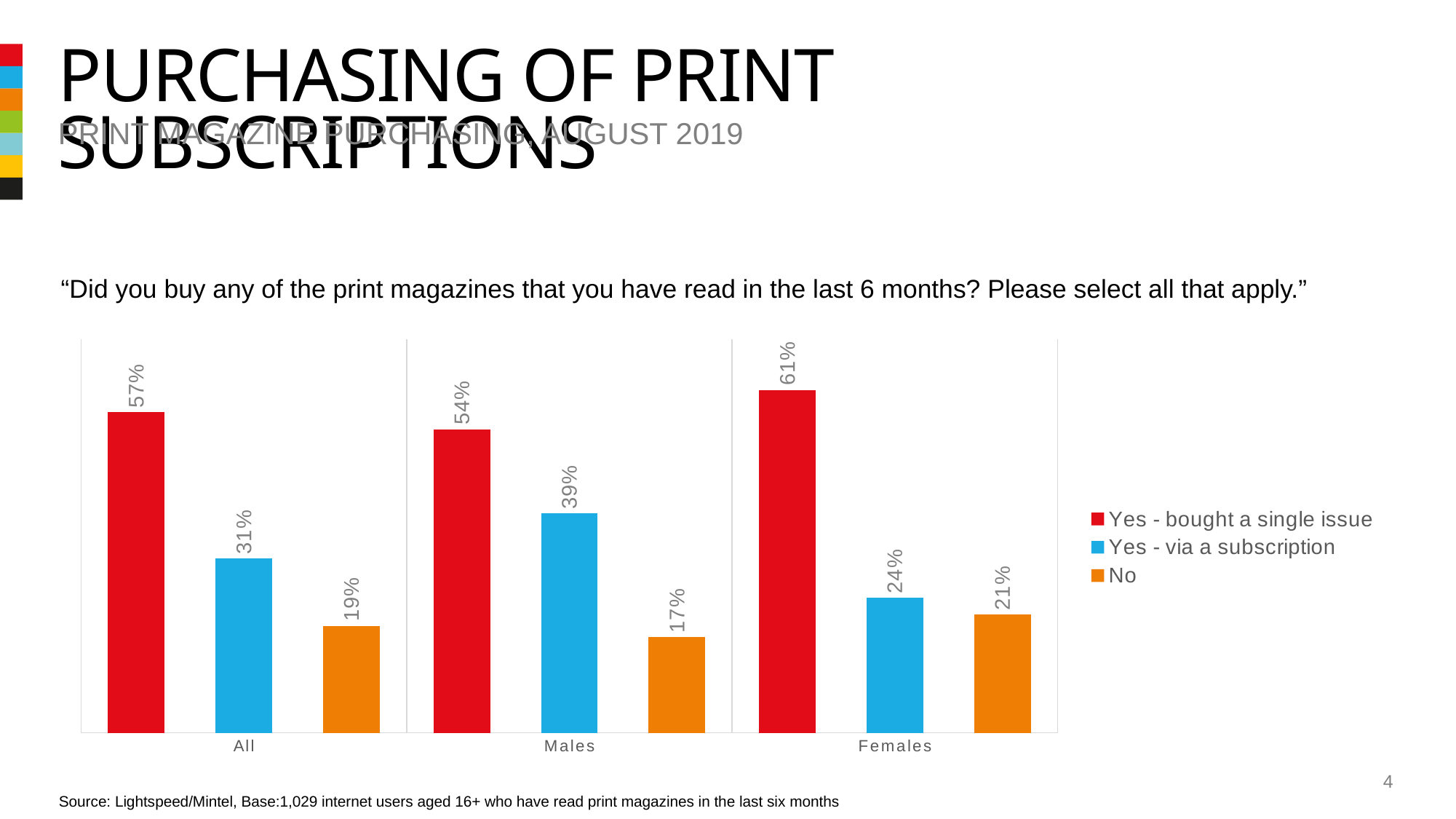
Which colour represents the 'No' series? Orange How many groups are shown on the x axis? 3 What percentage of All respondents said 'Yes - bought a single issue'? 57% What kind of chart is shown on the slide? Bar chart Which group has the highest value for 'Yes - bought a single issue'? Females Which group has the lowest value for 'No'? Males What is the difference between Males and Females for 'Yes - via a subscription'? 15 percentage points How many series does the legend list? 3 What percentage of Females answered 'No'? 21% What is the difference between 'Yes - bought a single issue' for Females and for Males? 7 percentage points Which is larger: 'Yes - via a subscription' for All or 'No' for All? Yes - via a subscription for All What is the value for 'Yes - via a subscription' among Males? 39%